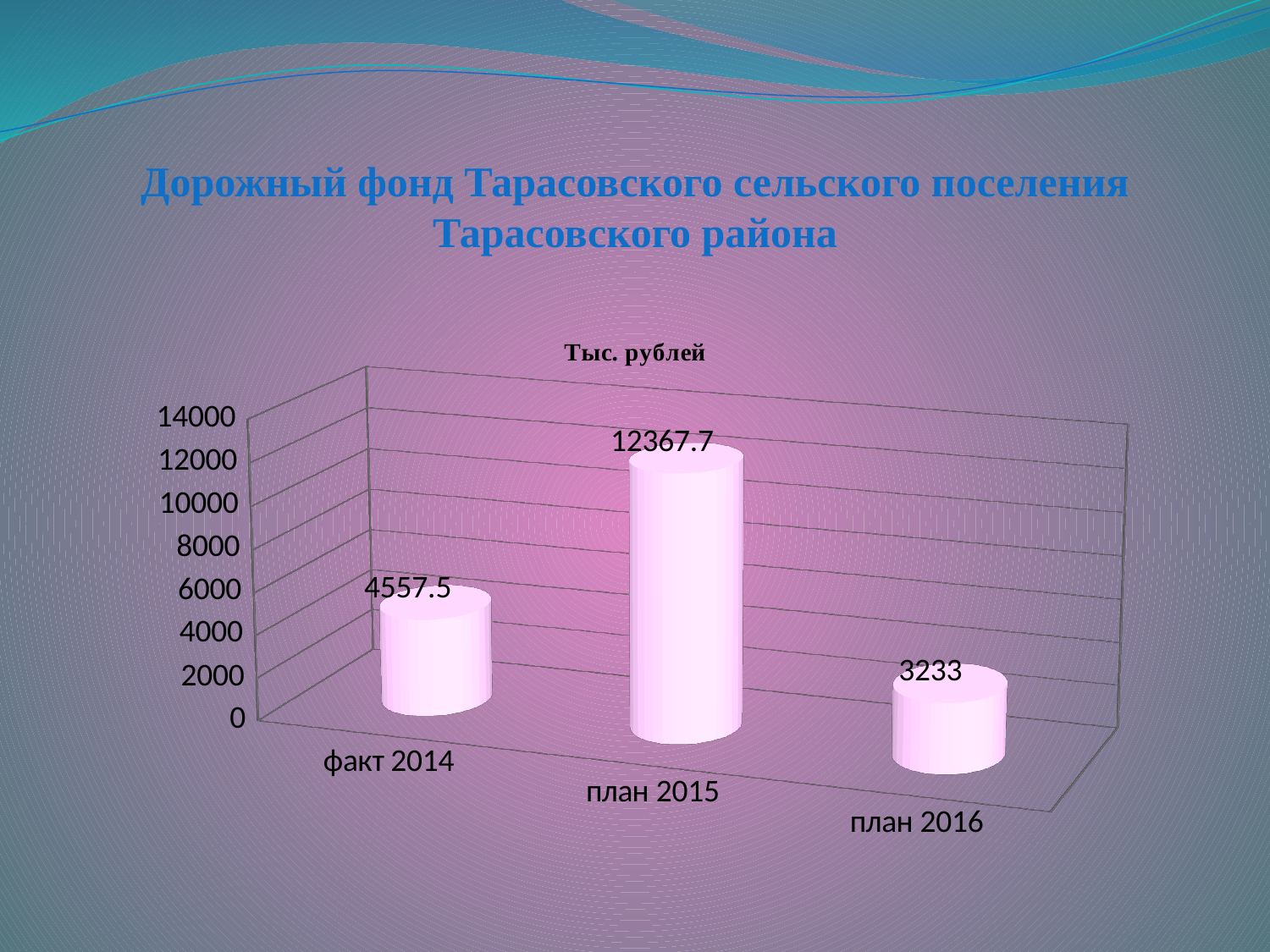
Is the value for план 2015 greater or less than 10000? greater Which is larger, the value for факт 2014 or the value for план 2016? факт 2014 What is the difference between the values for факт 2014 and план 2016? 1324.5 Which category has the highest value? план 2015 What is the difference between the values for план 2015 and факт 2014? 7810.2 What is the value for факт 2014? 4557.5 What kind of chart is shown on the slide? bar chart How many categories are shown on the x axis? 3 What is the value for план 2016? 3233 What is the value for план 2015? 12367.7 Which category has the lowest value? план 2016 What is the title of the chart? Тыс. рублей